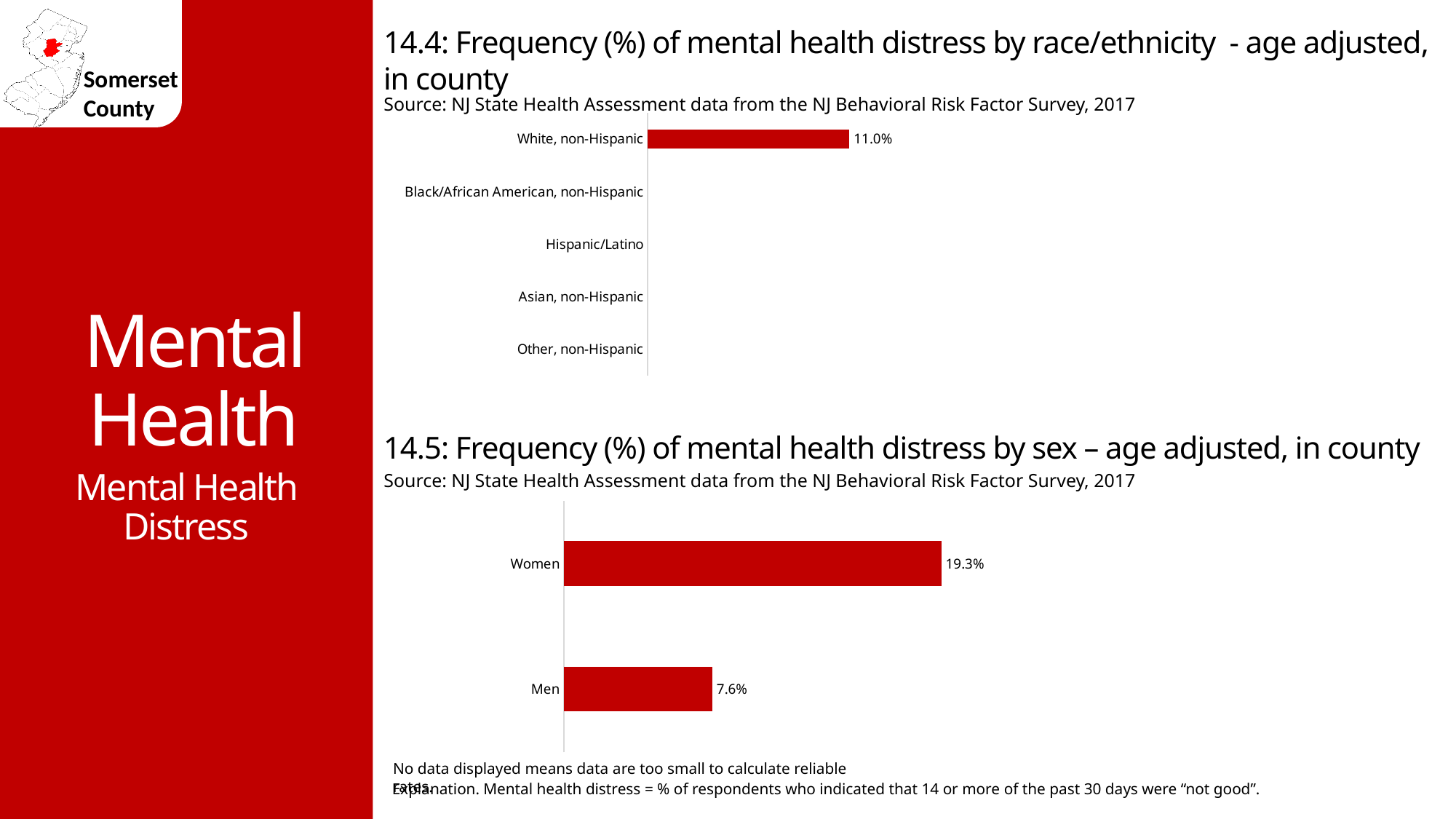
In the chart 14.5 (by sex), which category has the highest value? Women In the chart 14.5 (by sex), what is the value for Women? 19.3% In the chart 14.5 (by sex), what is the difference between the values for Women and Men? 11.7% In the chart 14.5 (by sex), which is larger, the value for Women or the value for Men? Women In the chart 14.4 (by race/ethnicity), how many race/ethnicity categories are listed on the axis? 5 In the chart 14.4 (by race/ethnicity), which category is the only one with a bar displayed? White, non-Hispanic In the chart 14.5 (by sex), what is the value for Men? 7.6% What kind of chart is chart 14.4 (by race/ethnicity)? Bar chart In the chart 14.5 (by sex), which category has the lowest value? Men In the chart 14.5 (by sex), how many categories are shown? 2 In the chart 14.4 (by race/ethnicity), what is the value for White, non-Hispanic? 11.0% What kind of chart is chart 14.5 (by sex)? Bar chart